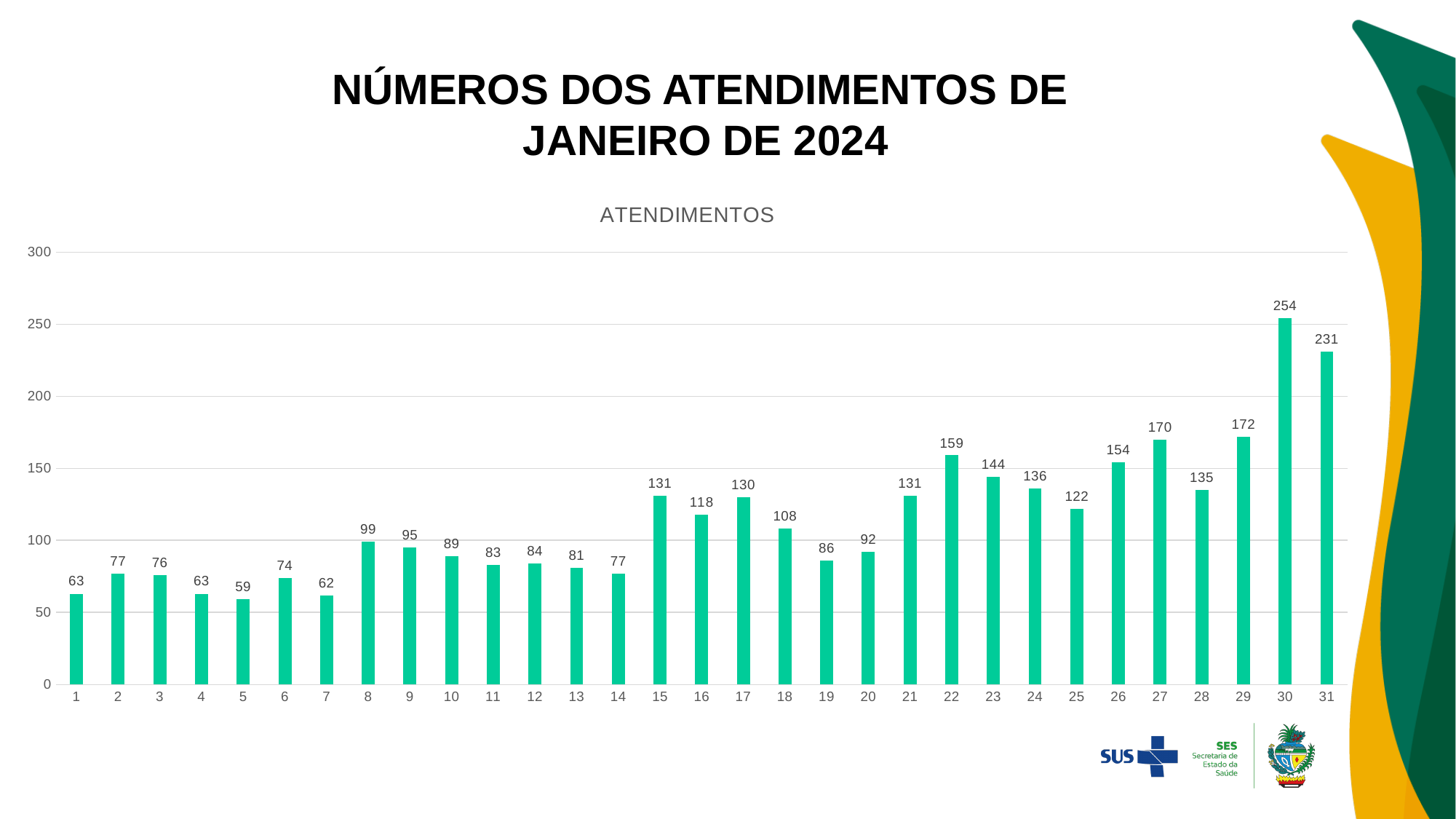
What is the value for day 5? 59 Which day has the highest value? 30 How many days are shown on the x axis? 31 What is the difference between the values for day 30 and day 31? 23 Which day has the lowest value? 5 What kind of chart is shown? bar chart What is the title of the chart? ATENDIMENTOS Which is larger, the value for day 27 or the value for day 29? day 29 Do the values generally rise or fall from day 1 to day 31? rise What is the value for day 30? 254 What is the value for day 22? 159 Is the value for day 15 greater or less than 100? greater